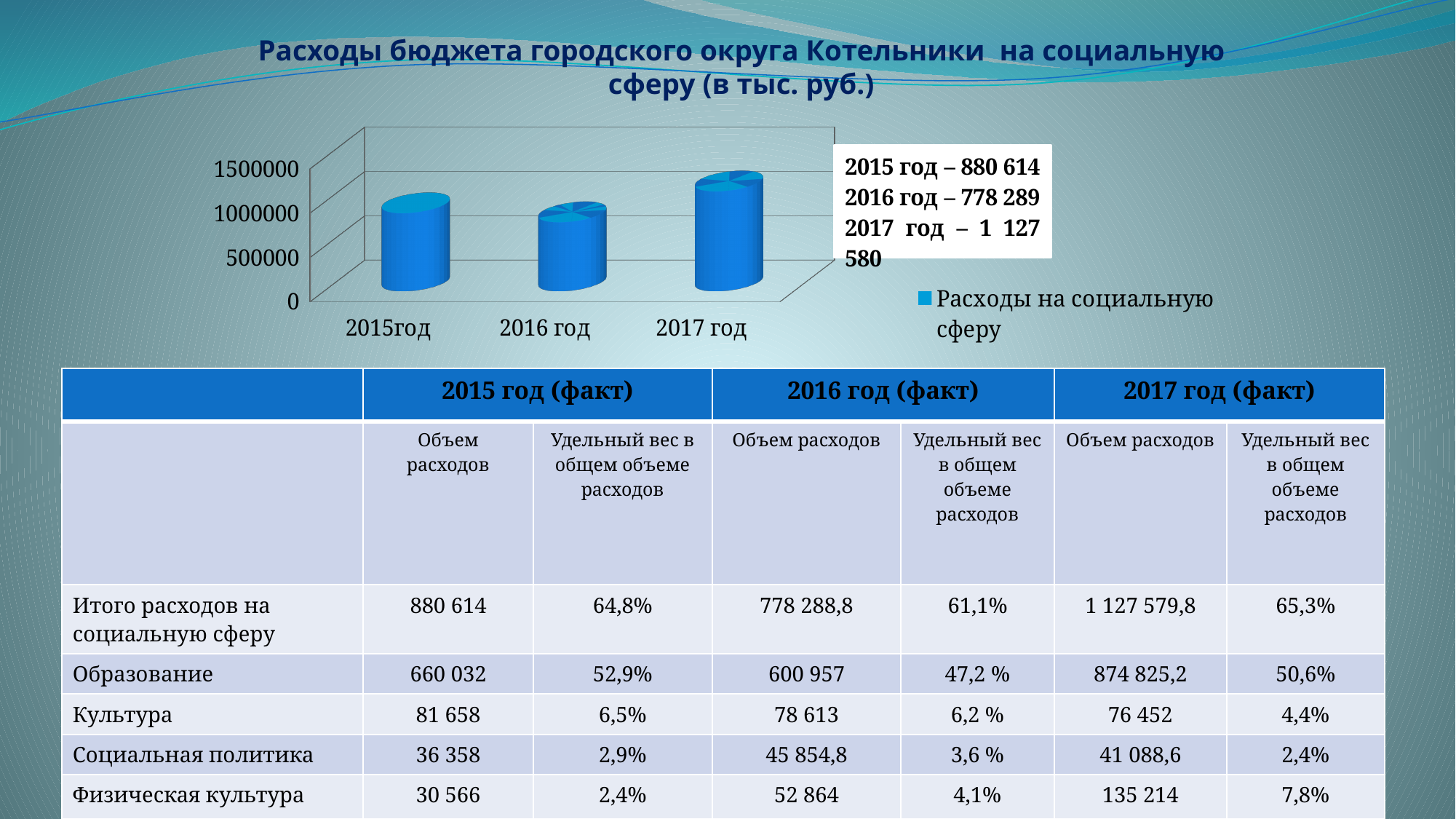
Which year has the lowest value in the chart? 2016 год Which is larger, the value for 2015 год or the value for 2016 год? 2015 год What is the legend entry of the chart? Расходы на социальную сферу What kind of chart is shown on the slide? bar chart What is the value for 2016 год in the chart? 778 289 What is the difference between the values for 2017 год and 2015 год? 246 966 What is the value for 2017 год in the chart? 1 127 580 Is the value for 2017 год greater or less than 1000000? greater Which year has the highest value in the chart? 2017 год What is the value for 2015 год in the chart? 880 614 What is the difference between the values for 2015 год and 2016 год? 102 325 How many years are shown in the chart? 3